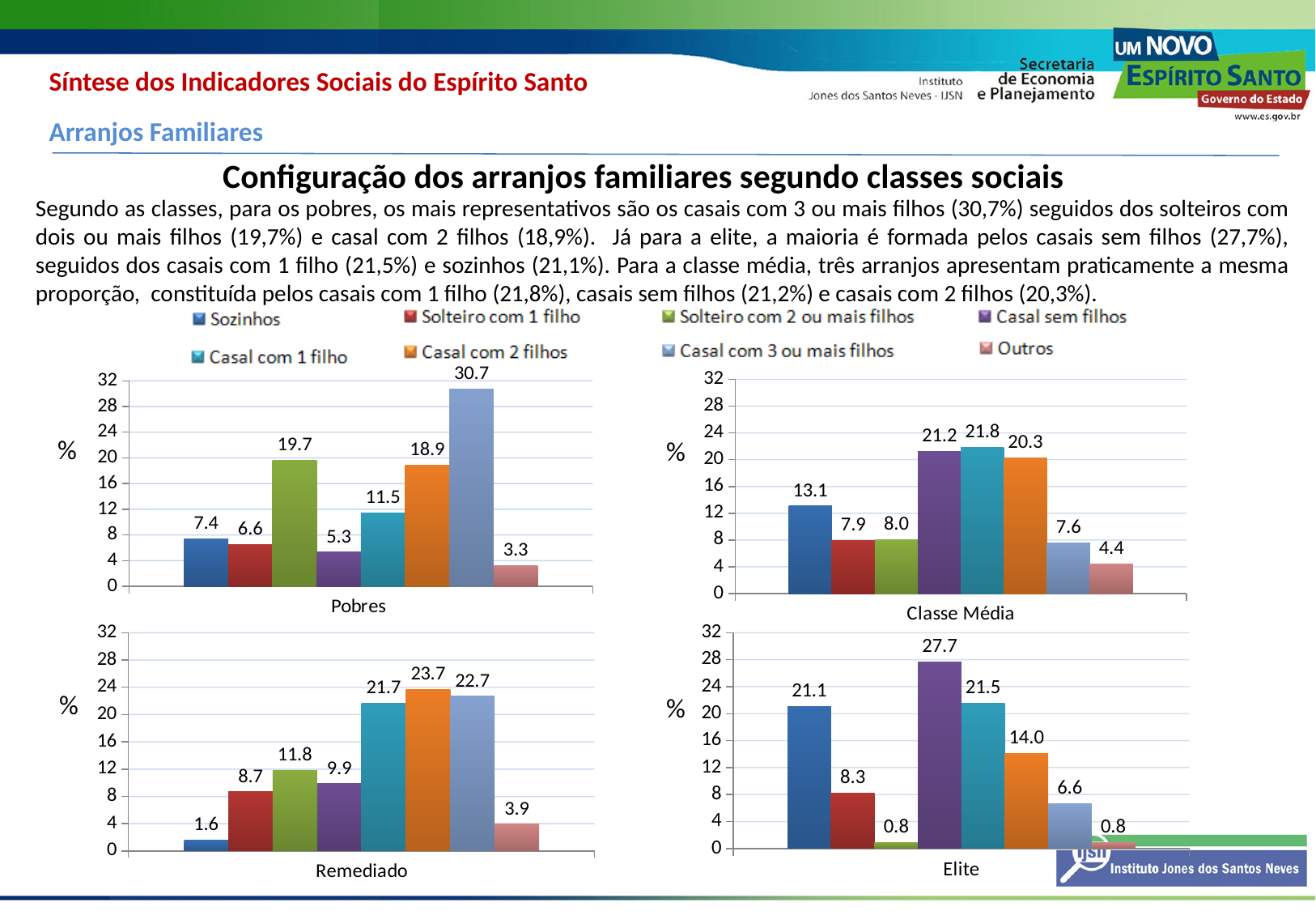
How many bar charts are shown on the slide? 4 In the Elite chart, which family arrangement has the highest value? Casal sem filhos In the Remediado chart, which family arrangement has the lowest value? Sozinhos What kind of chart is the Elite chart? Bar chart In the Remediado chart, what is the value for Casal com 2 filhos? 23.7 In the Elite chart, what is the difference between Casal sem filhos and Casal com 1 filho? 6.2 In the Classe Média chart, what is the value for Sozinhos? 13.1 In the Elite chart, what is the value for Solteiro com 2 ou mais filhos? 0.8 How many series does the legend list? 8 In the Pobres chart, which is larger: Solteiro com 2 ou mais filhos or Casal com 2 filhos? Solteiro com 2 ou mais filhos In the Pobres chart, what is the value for Casal com 3 ou mais filhos? 30.7 In the Classe Média chart, what is the difference between Casal com 1 filho and Outros? 17.4